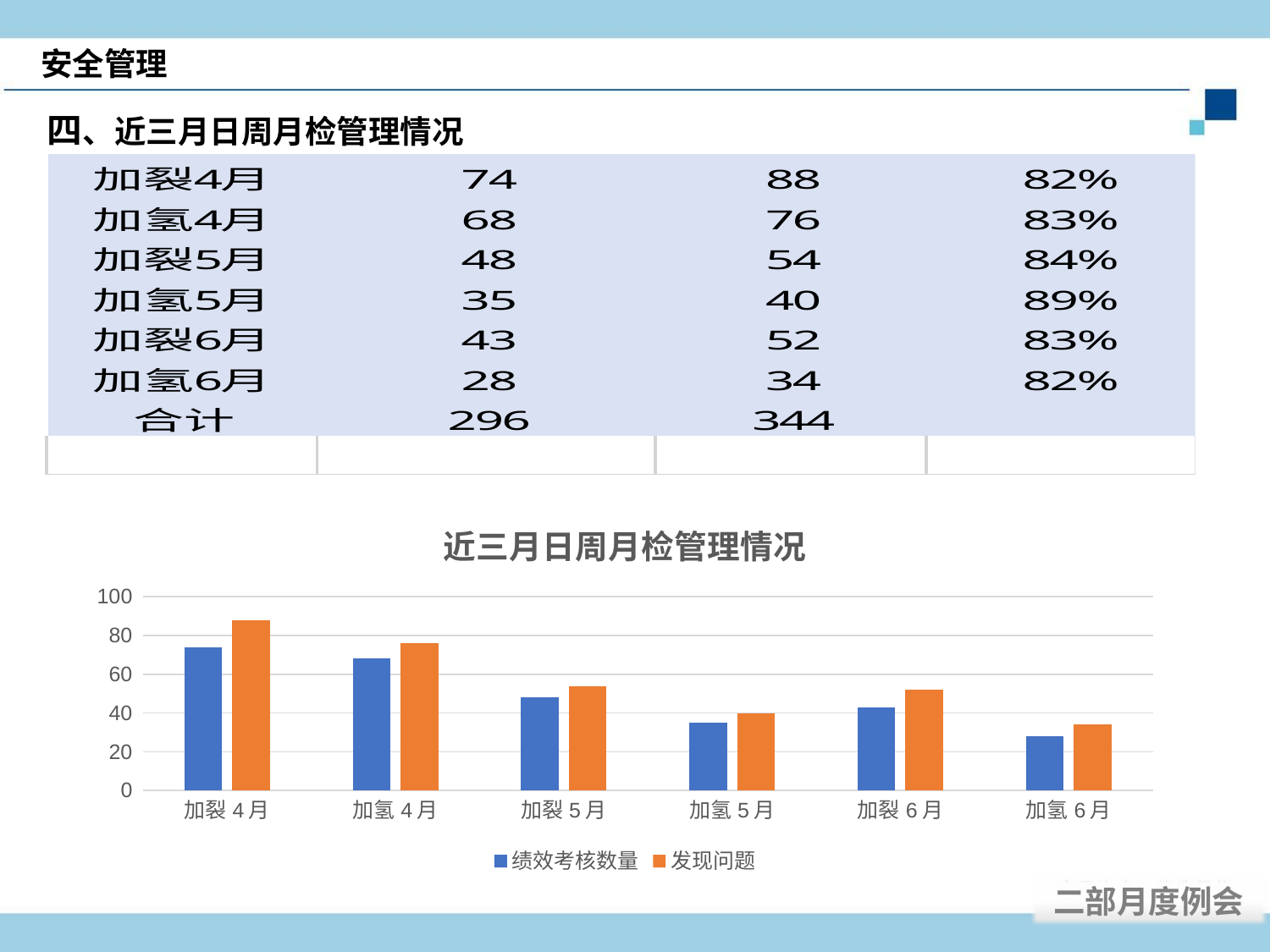
Which category has the highest 发现问题 value in the chart? 加裂4月 For 加裂5月, which series has the larger bar, 绩效考核数量 or 发现问题? 发现问题 How many categories are shown on the x axis of the chart? 6 Which is larger in the chart: the 绩效考核数量 bar for 加裂6月 or the 绩效考核数量 bar for 加氢5月? 加裂6月 How many series does the chart legend list? 2 Which category has the lowest 绩效考核数量 value in the chart? 加氢6月 In the chart, is the 发现问题 bar for 加裂4月 greater or less than 80? greater In the chart, is the 发现问题 bar for 加氢4月 greater or less than 60? greater What type of chart is shown under the title 近三月日周月检管理情况? bar chart Do the 绩效考核数量 bars for the 加裂 categories rise or fall from 加裂4月 to 加裂6月? fall In the chart, is the 绩效考核数量 bar for 加氢6月 greater or less than 40? less Which colour represents the 发现问题 series in the chart? orange